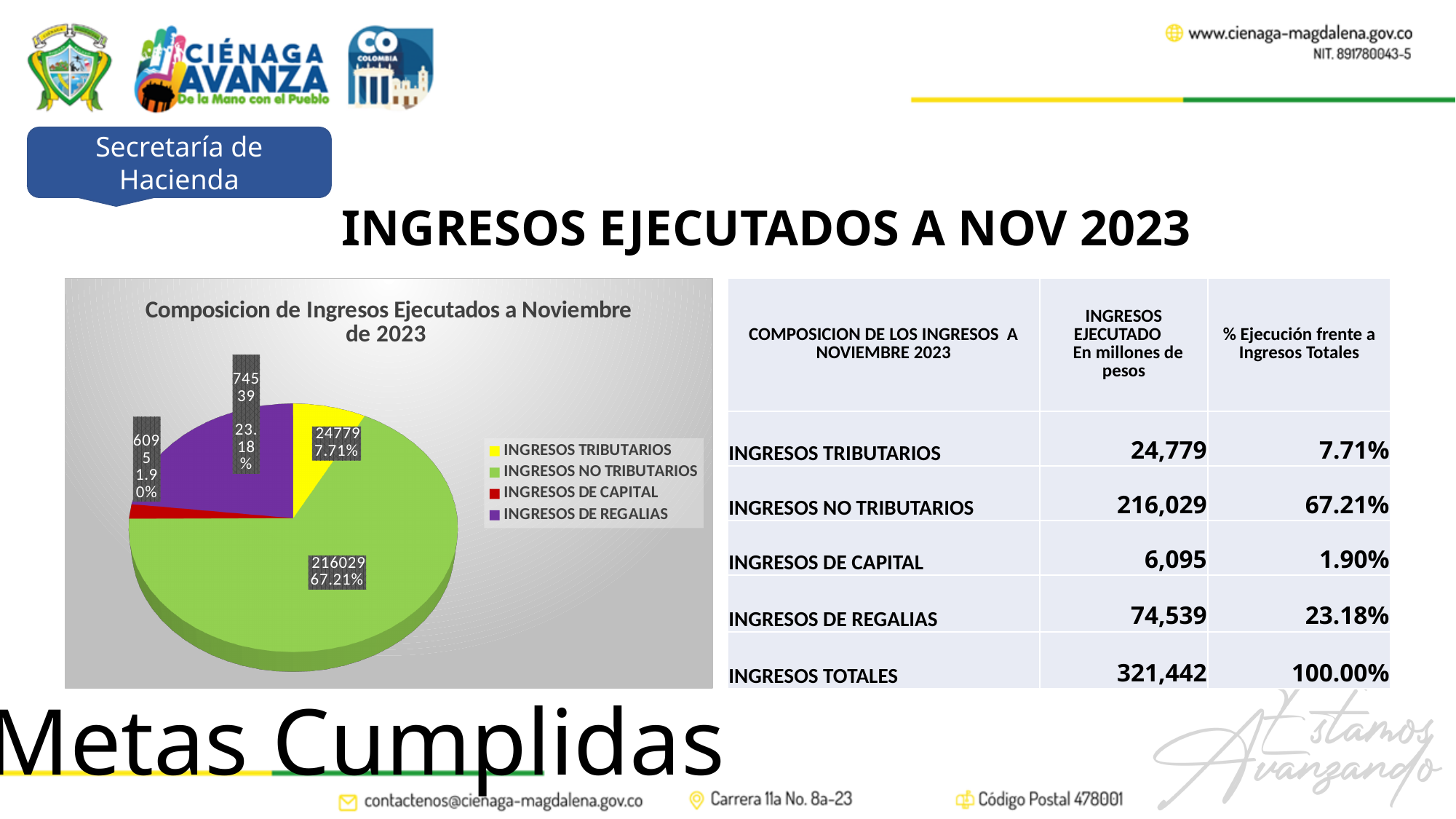
What share of the pie does INGRESOS DE REGALIAS represent? 23.18% What share of the pie does INGRESOS DE CAPITAL represent? 1.90% What is the title of the pie chart? Composicion de Ingresos Ejecutados a Noviembre de 2023 How many entries does the pie chart's legend list? 4 What kind of chart is shown on the slide? pie chart What share of the pie does INGRESOS TRIBUTARIOS represent? 7.71% How many slices does the pie chart have? 4 Which category has the largest slice in the pie chart? INGRESOS NO TRIBUTARIOS Which category has the smallest slice in the pie chart? INGRESOS DE CAPITAL What value is labelled on the INGRESOS TRIBUTARIOS slice of the pie chart? 24779 What value is labelled on the INGRESOS NO TRIBUTARIOS slice of the pie chart? 216029